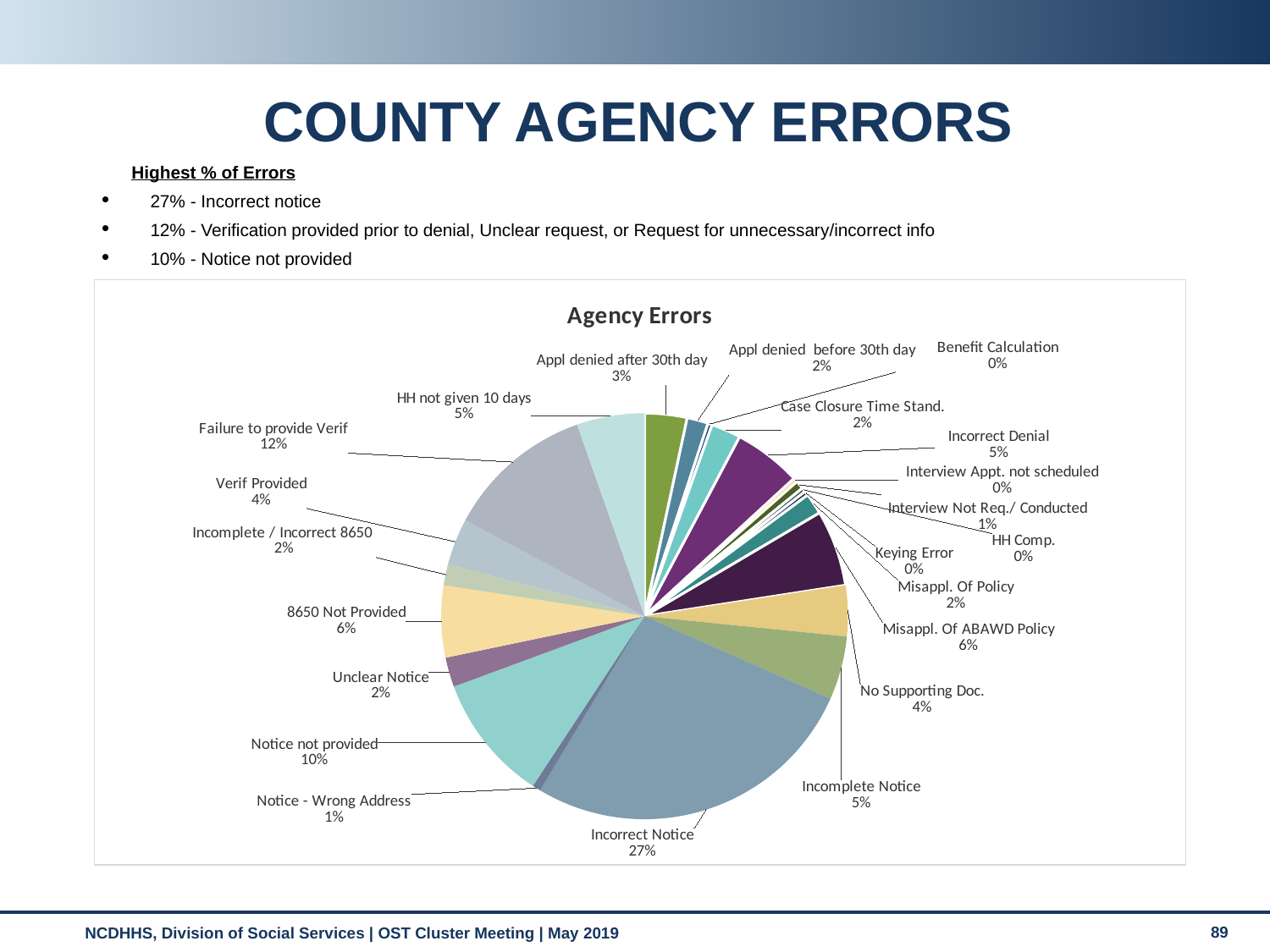
Which category has the largest slice of the pie? Incorrect Notice What kind of chart is shown on the slide? pie chart What share of agency errors is Notice not provided? 10% What percentage is shown for Misappl. Of ABAWD Policy? 6% What percentage is shown for Incomplete Notice? 5% How many categories are labelled in the pie chart? 22 What share of agency errors is Failure to provide Verif? 12% What is the title of the chart? Agency Errors What is the difference in percentage points between Incorrect Notice and Notice not provided? 17 What percentage is shown for HH not given 10 days? 5% Which is larger, the share for 8650 Not Provided or the share for Verif Provided? 8650 Not Provided What share of agency errors is Incorrect Notice? 27%